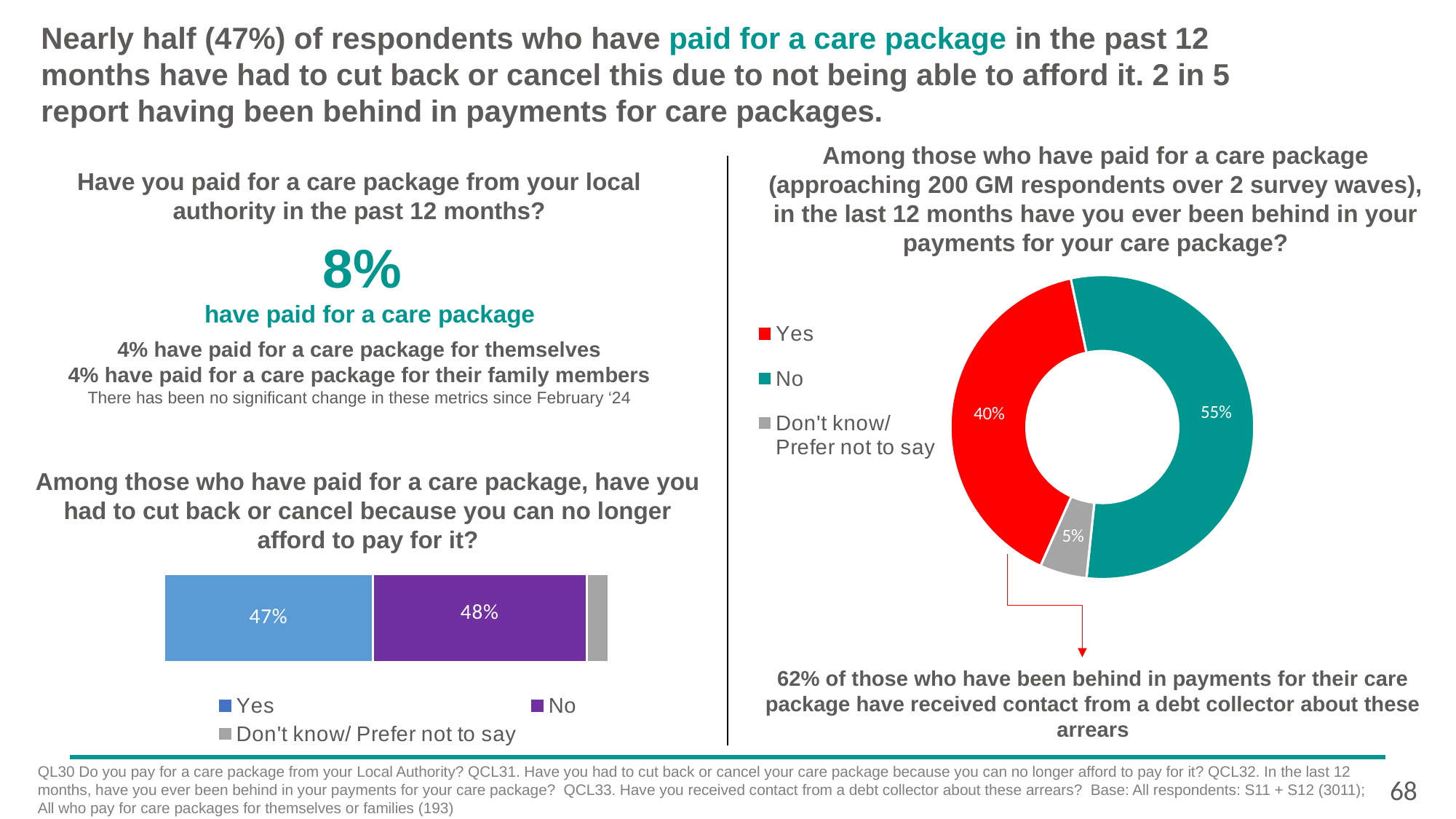
In the bar chart on the bottom left, how many entries does the legend list? 3 In the donut chart on the right, what percentage answered 'No'? 55% In the donut chart on the right, what percentage answered 'Yes' to having been behind in payments for their care package? 40% In the donut chart on the right, which response has the largest share? No In the donut chart on the right, which response has the smallest share? Don't know/ Prefer not to say In the bar chart on the bottom left about cutting back or cancelling a care package, what percentage answered 'Yes'? 47% What type of chart is used on the right of the slide for the behind-in-payments question? Donut chart In the donut chart on the right, what colour represents the 'Yes' response? Red In the donut chart on the right, what percentage answered 'Don't know/ Prefer not to say'? 5% In the donut chart on the right, what is the difference in percentage points between 'No' and 'Yes'? 15 What type of chart is used on the bottom left of the slide for the cut back or cancel question? Stacked bar chart In the bar chart on the bottom left about cutting back or cancelling a care package, what percentage answered 'No'? 48%